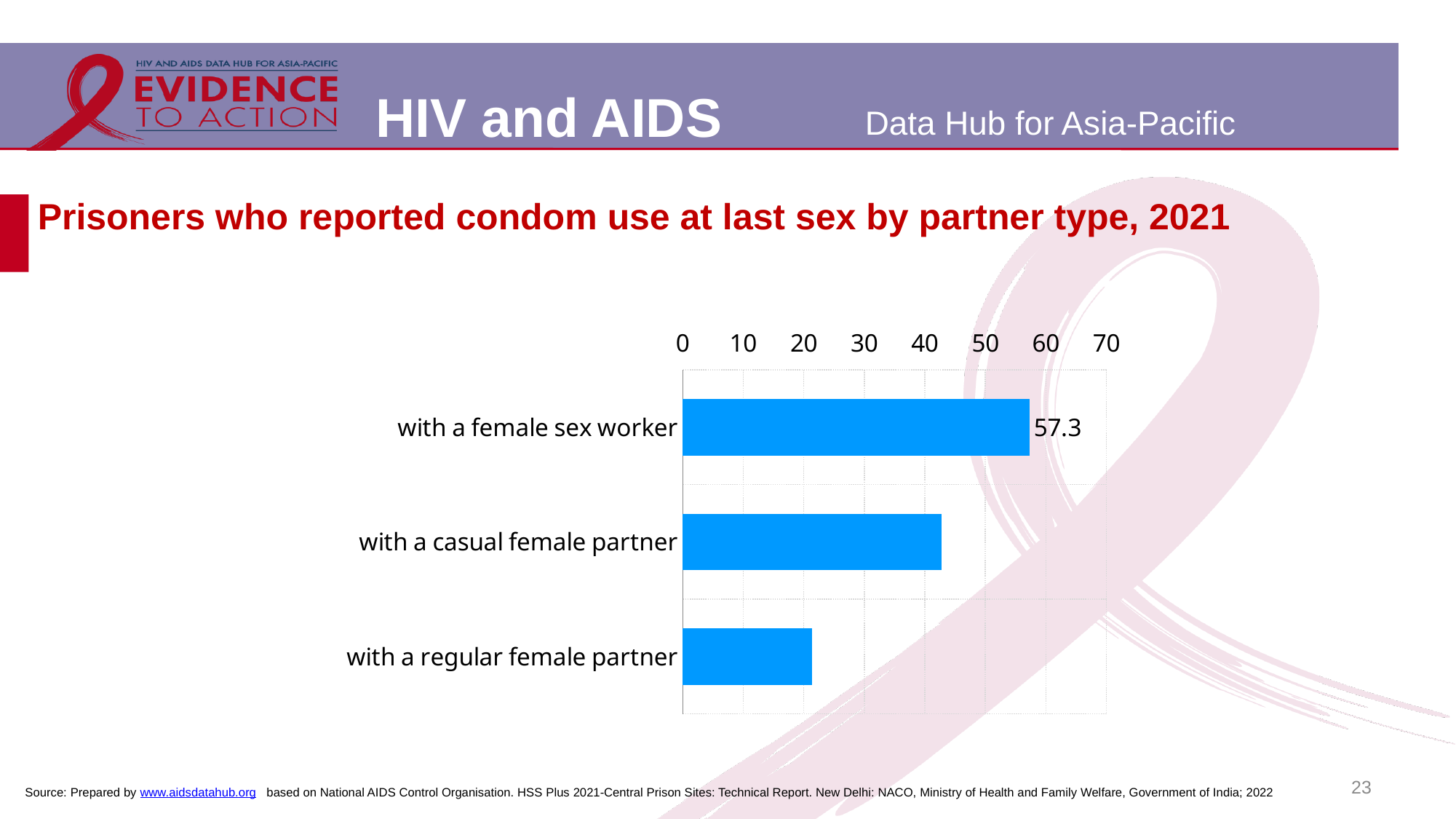
Which is larger: the value for a casual female partner or the value for a regular female partner? with a casual female partner What kind of chart is shown on the slide? bar chart Is the value for a casual female partner greater or less than 50? less What is the value for prisoners who reported condom use at last sex with a female sex worker? 57.3 Which partner type has the lowest reported condom use at last sex? with a regular female partner Is the value for a female sex worker greater or less than 50? greater What is the title of the chart on the slide? Prisoners who reported condom use at last sex by partner type, 2021 How many partner types are shown in the chart? 3 Which partner type has the highest reported condom use at last sex? with a female sex worker Is the value for a regular female partner greater or less than 30? less What is the highest value shown on the chart's axis? 70